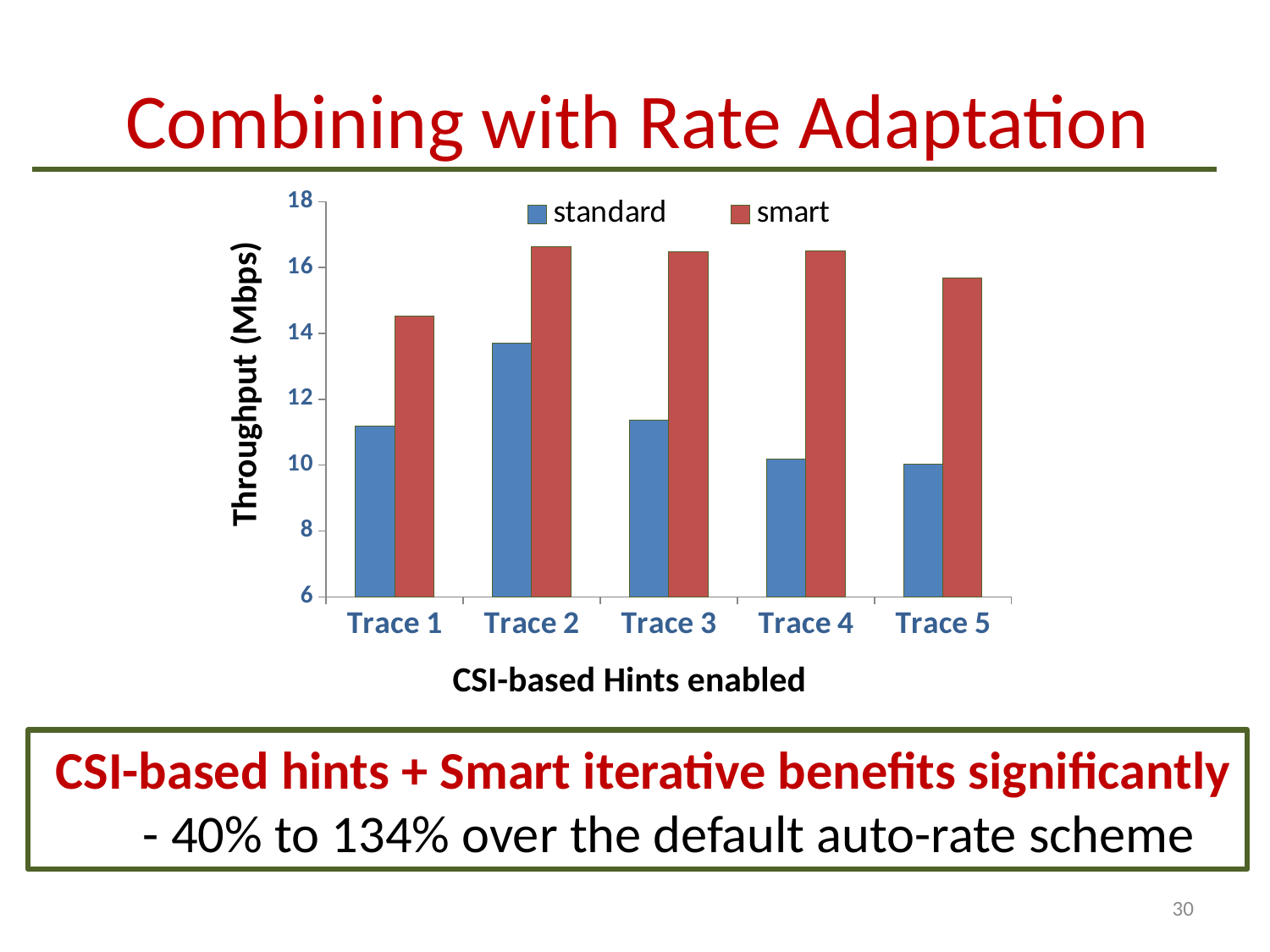
How many traces (categories) are shown on the x axis? 5 How many series does the legend list? 2 What kind of chart is shown on the slide? bar chart Which trace has the lowest smart throughput? Trace 1 Is the smart throughput for Trace 1 greater or less than 16 Mbps? less Which trace has the highest standard throughput? Trace 2 Is the standard throughput for Trace 4 greater or less than 12 Mbps? less Is the standard throughput for Trace 2 greater or less than 12 Mbps? greater What is the label of the y axis? Throughput (Mbps) For Trace 1, which is larger: the standard or the smart throughput? smart Which is larger: the standard throughput for Trace 2 or for Trace 3? Trace 2